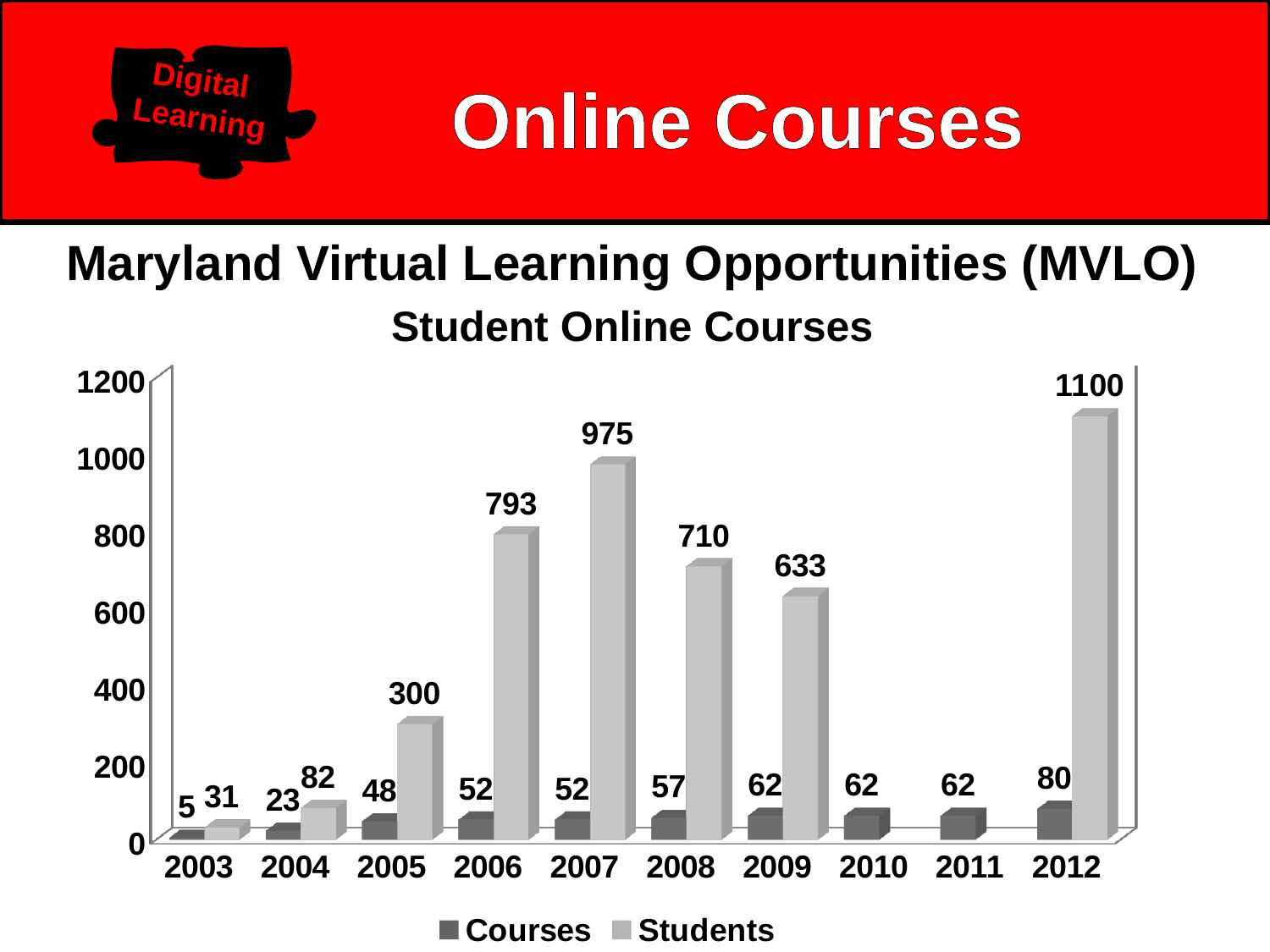
What kind of chart is shown? bar chart What is the value for Students in 2005? 300 How many series does the legend list? 2 Which year has the highest value for Students? 2012 What is the title of the chart? Student Online Courses Is the value for Students in 2009 greater or less than 600? greater What is the value for Courses in 2012? 80 Which is larger, the Students value for 2006 or for 2008? 2006 How many years are shown on the x axis? 10 What is the value for Students in 2007? 975 Which year has the lowest value for Courses? 2003 What is the difference between the Students values for 2012 and 2007? 125